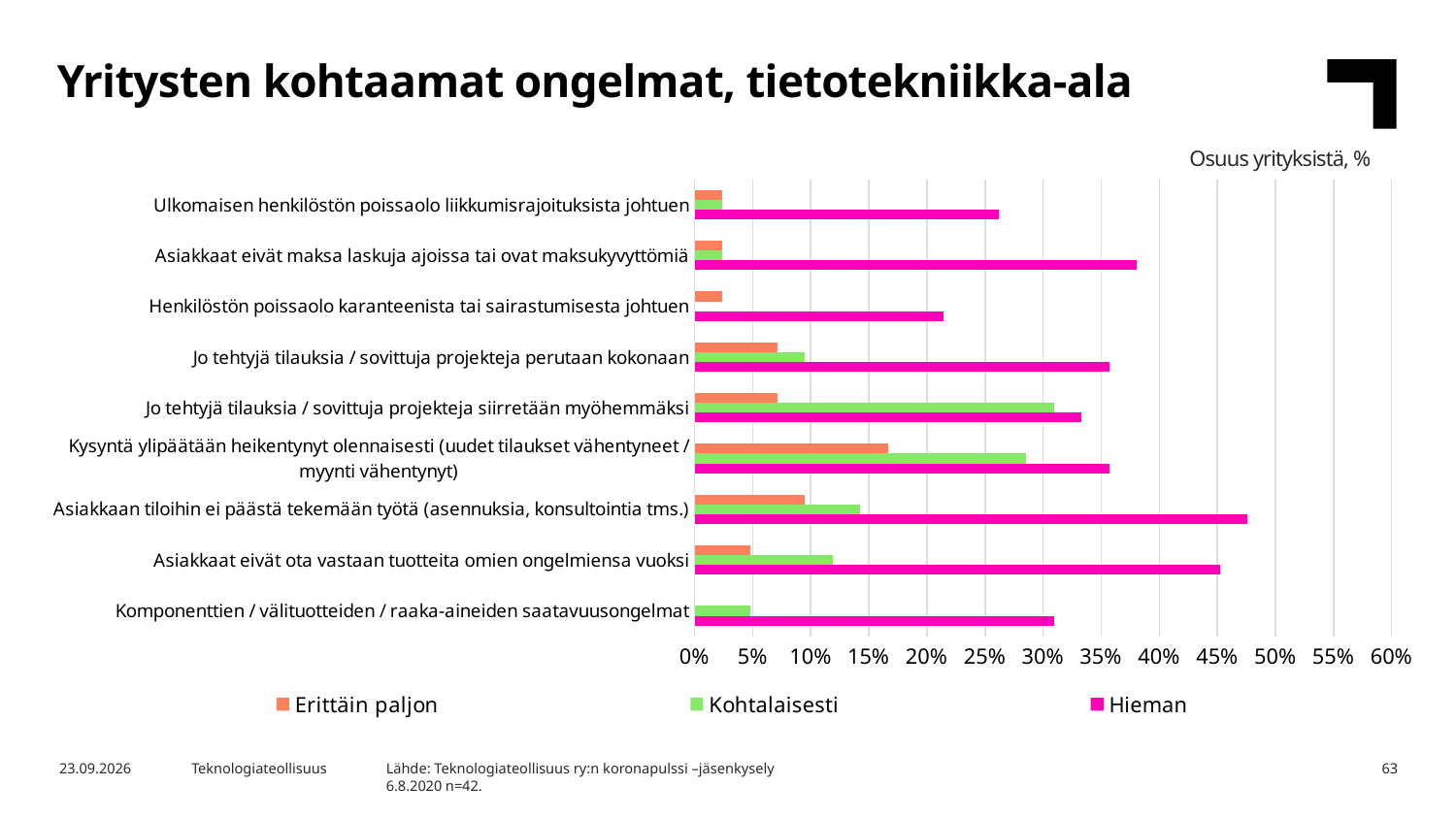
What is the title of the chart on the slide? Yritysten kohtaamat ongelmat, tietotekniikka-ala How many problem categories are plotted on the chart? 9 What kind of chart is shown on the slide? Bar chart Is the 'Erittäin paljon' value for 'Kysyntä ylipäätään heikentynyt olennaisesti (uudet tilaukset vähentyneet / myynti vähentynyt)' greater or less than 15%? greater Which category has the highest 'Erittäin paljon' value? Kysyntä ylipäätään heikentynyt olennaisesti (uudet tilaukset vähentyneet / myynti vähentynyt) Is the 'Hieman' value for 'Henkilöstön poissaolo karanteenista tai sairastumisesta johtuen' greater or less than 25%? less How many series does the legend list? 3 Is the 'Hieman' value for 'Asiakkaat eivät maksa laskuja ajoissa tai ovat maksukyvyttömiä' greater or less than 35%? greater Which is larger: the 'Hieman' value for 'Ulkomaisen henkilöstön poissaolo liikkumisrajoituksista johtuen' or for 'Asiakkaat eivät maksa laskuja ajoissa tai ovat maksukyvyttömiä'? Asiakkaat eivät maksa laskuja ajoissa tai ovat maksukyvyttömiä Which category has the highest 'Hieman' value? Asiakkaan tiloihin ei päästä tekemään työtä (asennuksia, konsultointia tms.) Which is larger for 'Jo tehtyjä tilauksia / sovittuja projekteja siirretään myöhemmäksi': the 'Erittäin paljon' value or the 'Kohtalaisesti' value? Kohtalaisesti